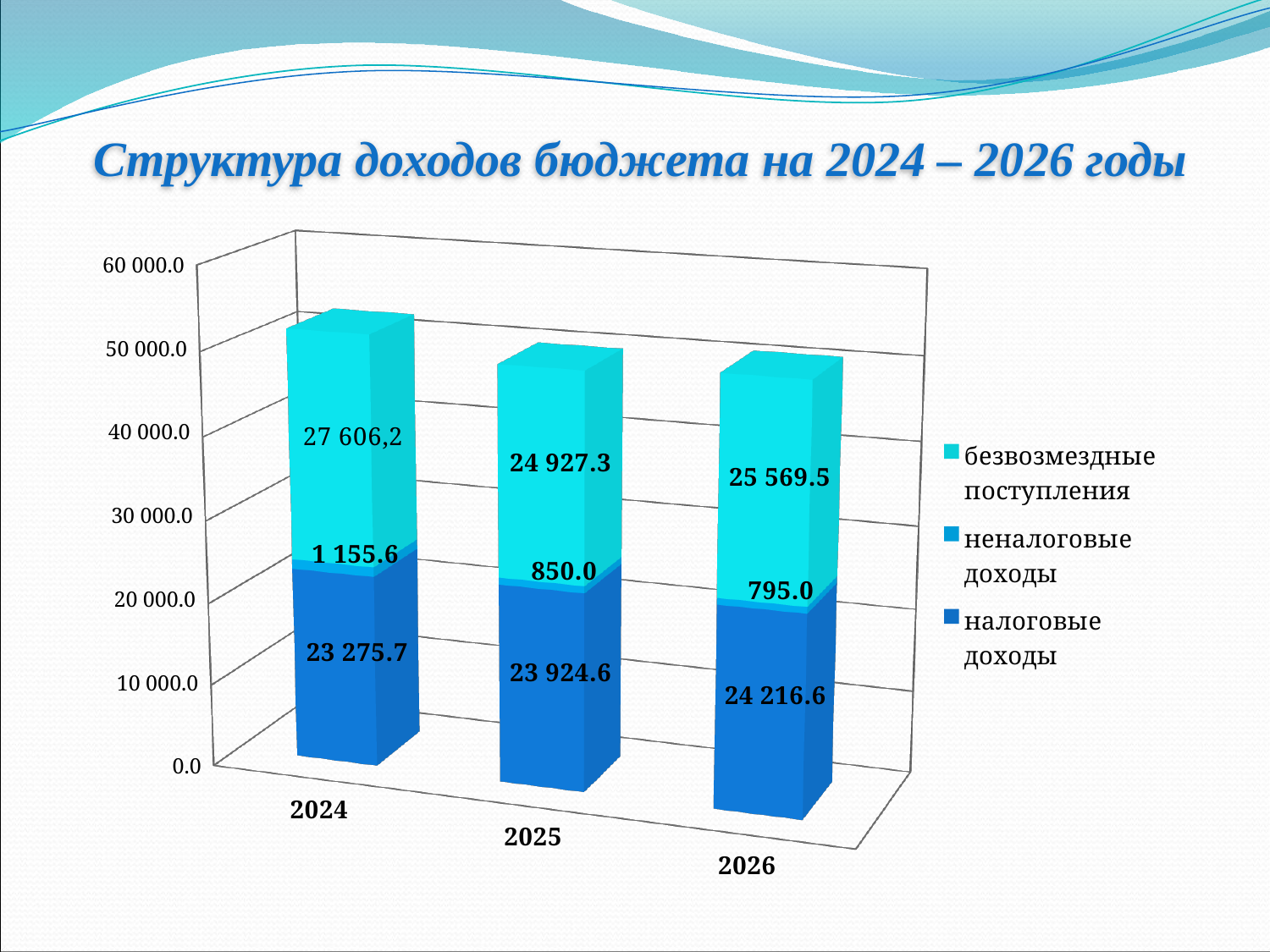
What is the value of неналоговые доходы for 2026? 795.0 What is the difference between налоговые доходы in 2026 and in 2025? 292.0 What is the value of налоговые доходы for 2024? 23 275.7 How many series does the legend list? 3 What is the total of the stacked bar for 2025? 49 701.9 How many years are shown on the x axis? 3 In which year are налоговые доходы the highest? 2026 What is the value of безвозмездные поступления for 2024? 27 606,2 Which is larger in 2025: налоговые доходы or безвозмездные поступления? безвозмездные поступления What kind of chart is shown on the slide? stacked bar chart What is the value of безвозмездные поступления for 2025? 24 927.3 In which year are неналоговые доходы the lowest? 2026